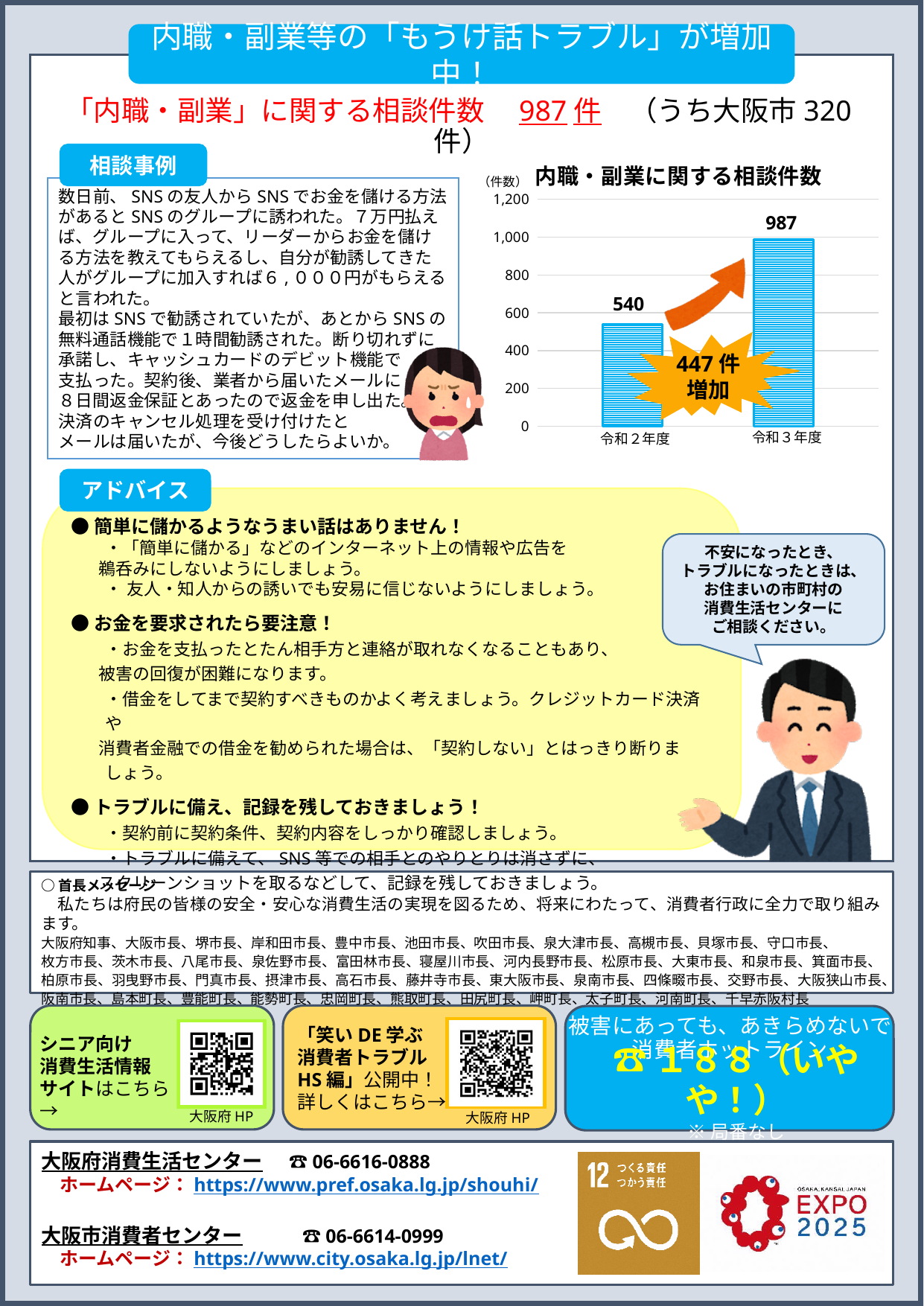
What is the value for 令和３年度 in the chart? 987 What is the difference between the values for 令和３年度 and 令和２年度? 447 Do the values rise or fall from 令和２年度 to 令和３年度? rise What kind of chart is shown on the slide? bar chart Is the value for 令和２年度 greater or less than 600? less Which category has the highest value in the chart? 令和３年度 What is the title of the chart? 内職・副業に関する相談件数 Is the value for 令和３年度 greater or less than 800? greater Which is larger, the value for 令和２年度 or the value for 令和３年度? 令和３年度 Which category has the lowest value in the chart? 令和２年度 What is the value for 令和２年度 in the chart? 540 How many categories are shown on the x axis of the chart? 2